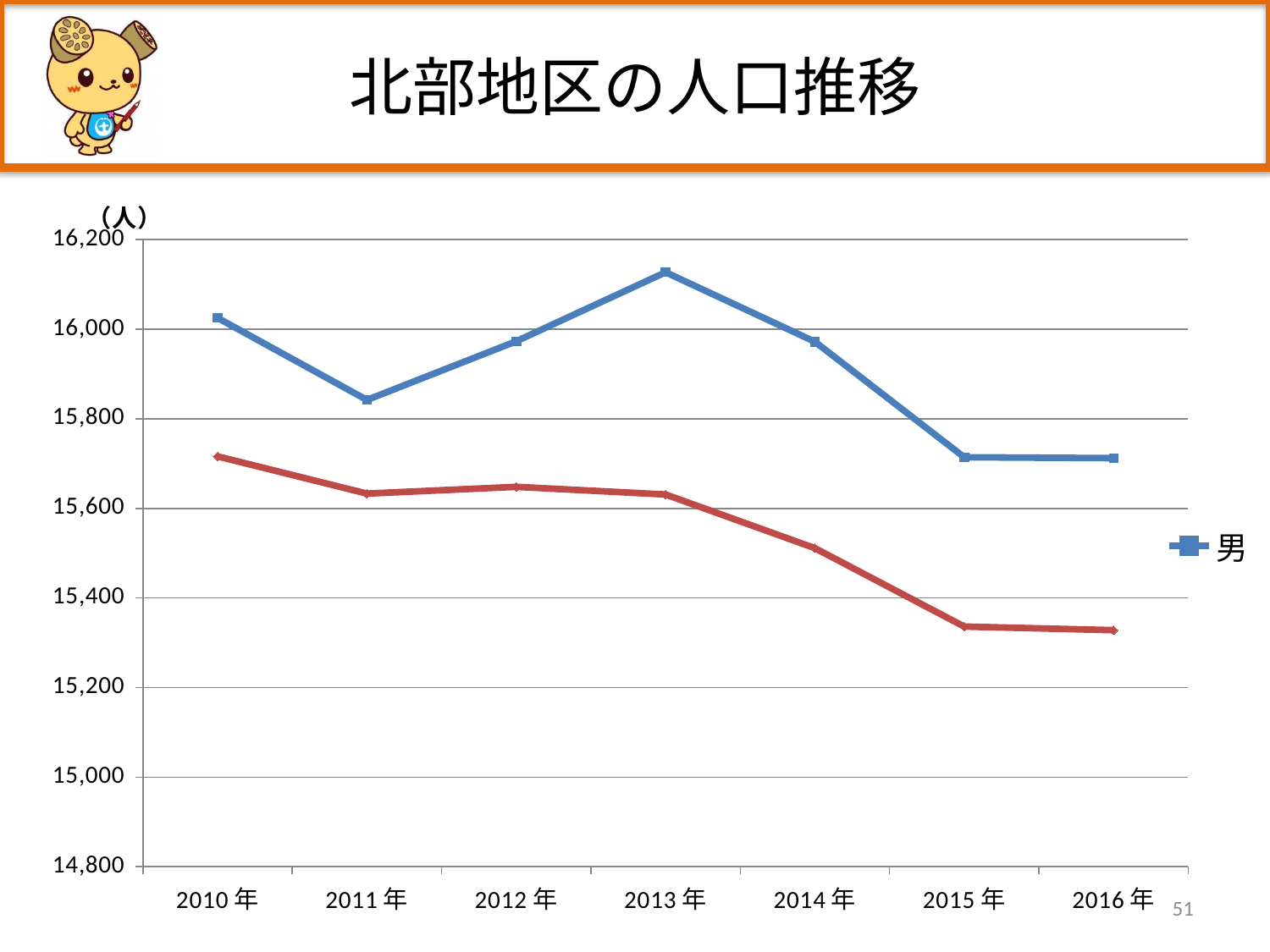
Does the value for 男 rise or fall from 2013年 to 2015年? fall In which year is the value of the red line highest? 2010年 Is the value for 男 in 2015年 greater or less than 15,800? less Is the value for 男 in 2013年 greater or less than 16,000? greater Which is larger for 男: the value in 2010年 or the value in 2011年? 2010年 What kind of chart is shown on the slide? line chart Is the value of the red line in 2015年 greater or less than 15,400? less How many series does the legend list? 1 How many years are plotted along the x axis? 7 In which year is the value for 男 highest? 2013年 What is the title of the chart? 北部地区の人口推移